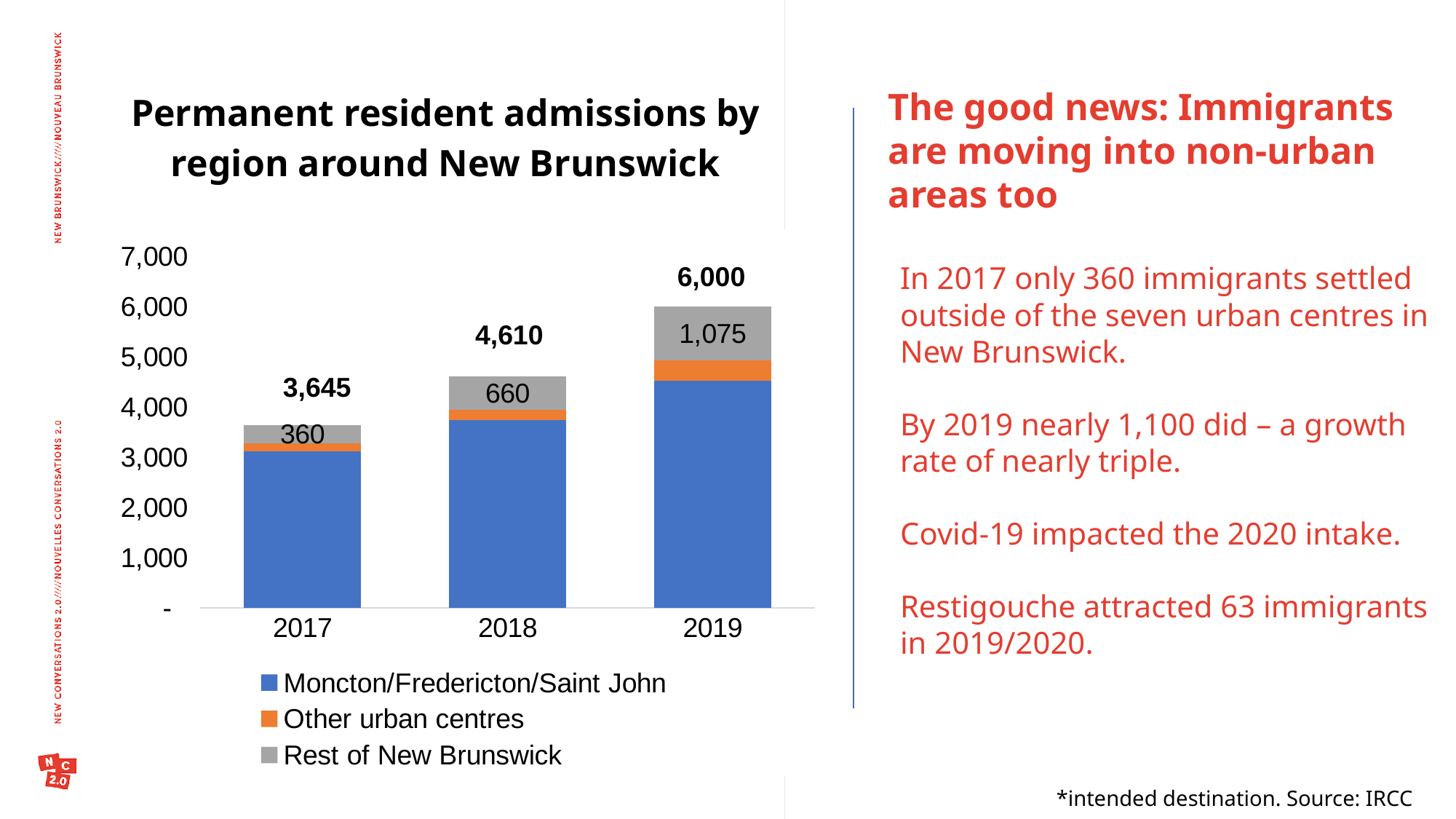
Do the total admissions rise or fall from 2017 to 2019? Rise What is the total permanent resident admissions shown for 2019? 6,000 Which year has the highest total permanent resident admissions? 2019 Which year has the lowest total permanent resident admissions? 2017 Is the Moncton/Fredericton/Saint John value for 2017 greater or less than 3,000? greater What value is labelled for Rest of New Brunswick in 2018? 660 How much larger is the Rest of New Brunswick value in 2019 than in 2017? 715 What value is labelled for Rest of New Brunswick in 2019? 1,075 How many series does the legend list? 3 What is the total permanent resident admissions shown for 2017? 3,645 What is the difference between the total admissions in 2019 and 2017? 2,355 What kind of chart is shown on the slide? Stacked bar chart